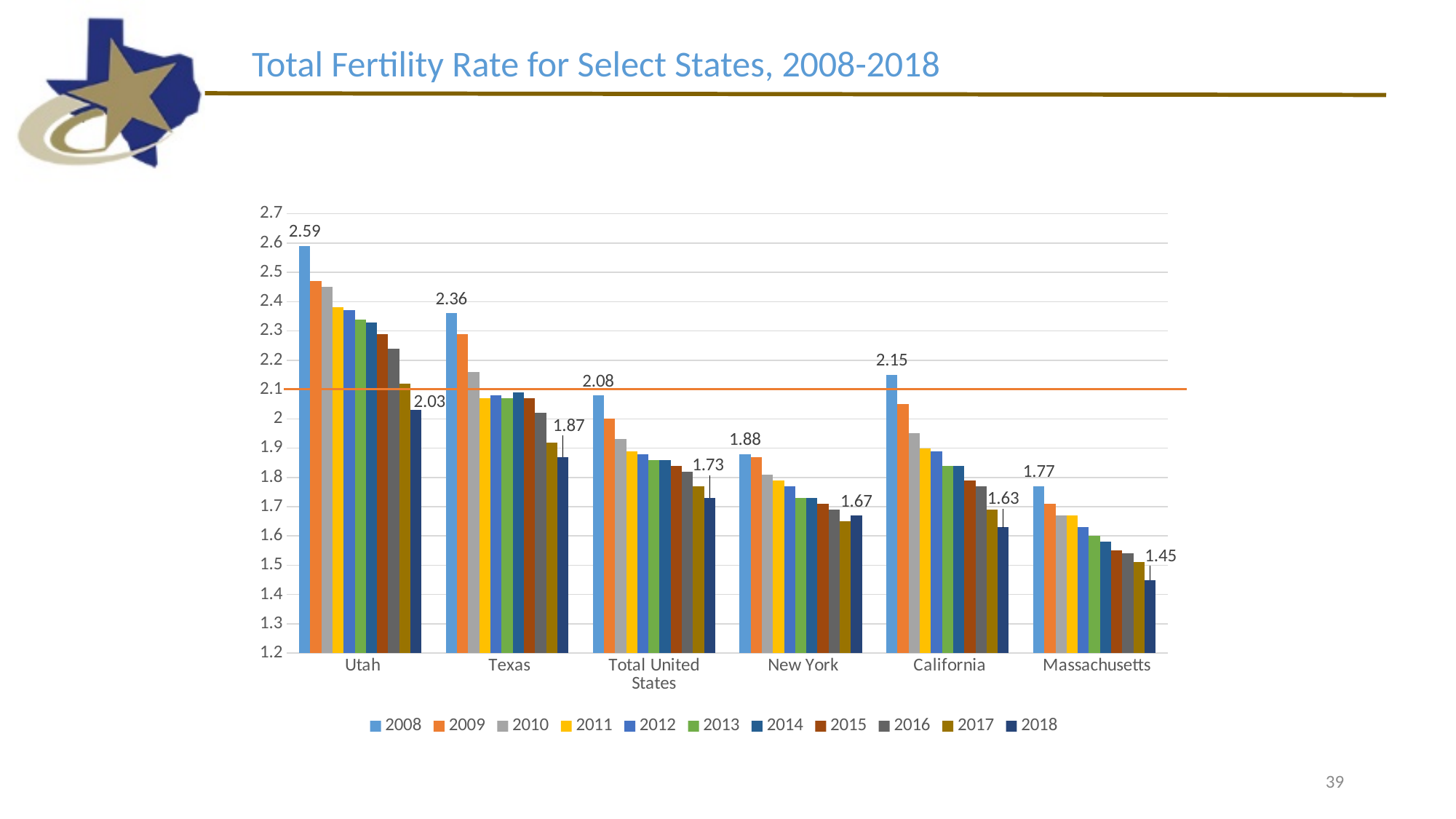
Which state had the highest total fertility rate in 2008? Utah What was the total fertility rate for Massachusetts in 2018? 1.45 What was the total fertility rate for California in 2008? 2.15 What was the total fertility rate for Utah in 2008? 2.59 Is the 2009 value for Utah greater or less than 2.4? greater Which was larger in 2018, the total fertility rate for New York or for California? New York Which category had the lowest total fertility rate in 2018? Massachusetts How many states or categories are shown on the x axis? 6 Do the values for Total United States rise or fall from 2008 to 2018? fall By how much did Texas's total fertility rate fall from 2008 to 2018? 0.49 How many years (series) does the legend list? 11 What was the total fertility rate for Texas in 2018? 1.87